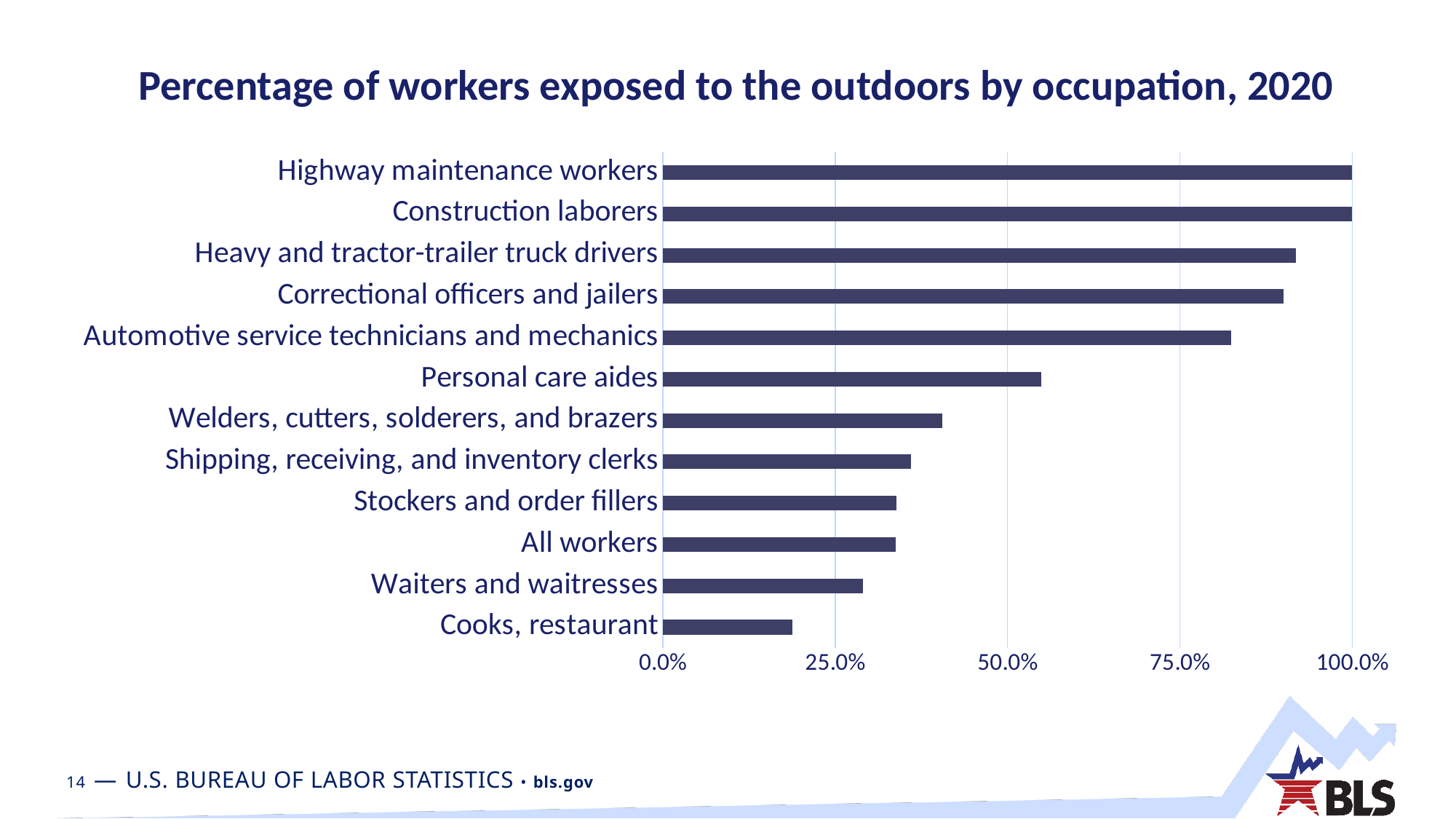
Is the value for Heavy and tractor-trailer truck drivers greater or less than 75.0%? greater Is the value for Cooks, restaurant greater or less than 25.0%? less What kind of chart is shown on the slide? Bar chart Is the value for Welders, cutters, solderers, and brazers greater or less than 50.0%? less How many occupations are plotted in the chart? 12 What is the percentage of workers exposed to the outdoors for Highway maintenance workers? 100.0% What is the percentage of workers exposed to the outdoors for Construction laborers? 100.0% Which has a higher percentage of workers exposed to the outdoors: Personal care aides or Welders, cutters, solderers, and brazers? Personal care aides Which occupation has the lowest percentage of workers exposed to the outdoors? Cooks, restaurant What is the title of the chart? Percentage of workers exposed to the outdoors by occupation, 2020 Which has a higher percentage of workers exposed to the outdoors: Waiters and waitresses or Cooks, restaurant? Waiters and waitresses